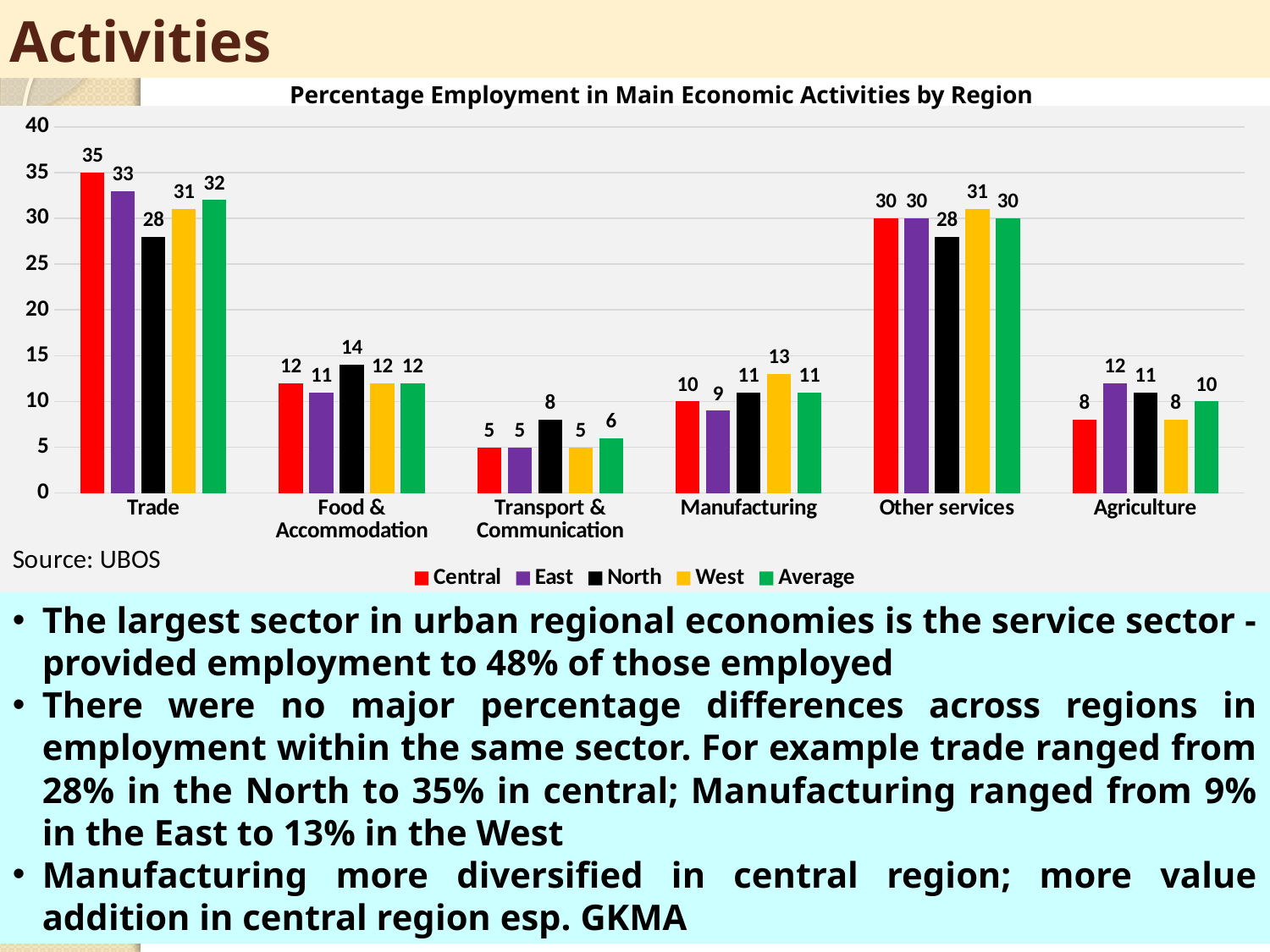
Which is larger in Manufacturing: the value for East or the value for West? West How many economic activity categories are shown on the x axis? 6 What is the title of the chart? Percentage Employment in Main Economic Activities by Region How many series does the legend list? 5 What is the difference between the Central and North values in Trade? 7 What is the value for Central in Trade? 35 What is the value for North in Food & Accommodation? 14 Which region has the highest value in Agriculture? East Which region has the lowest value in Trade? North What is the value for West in Manufacturing? 13 What is the value for Average in Transport & Communication? 6 What kind of chart is shown on the slide? Bar chart